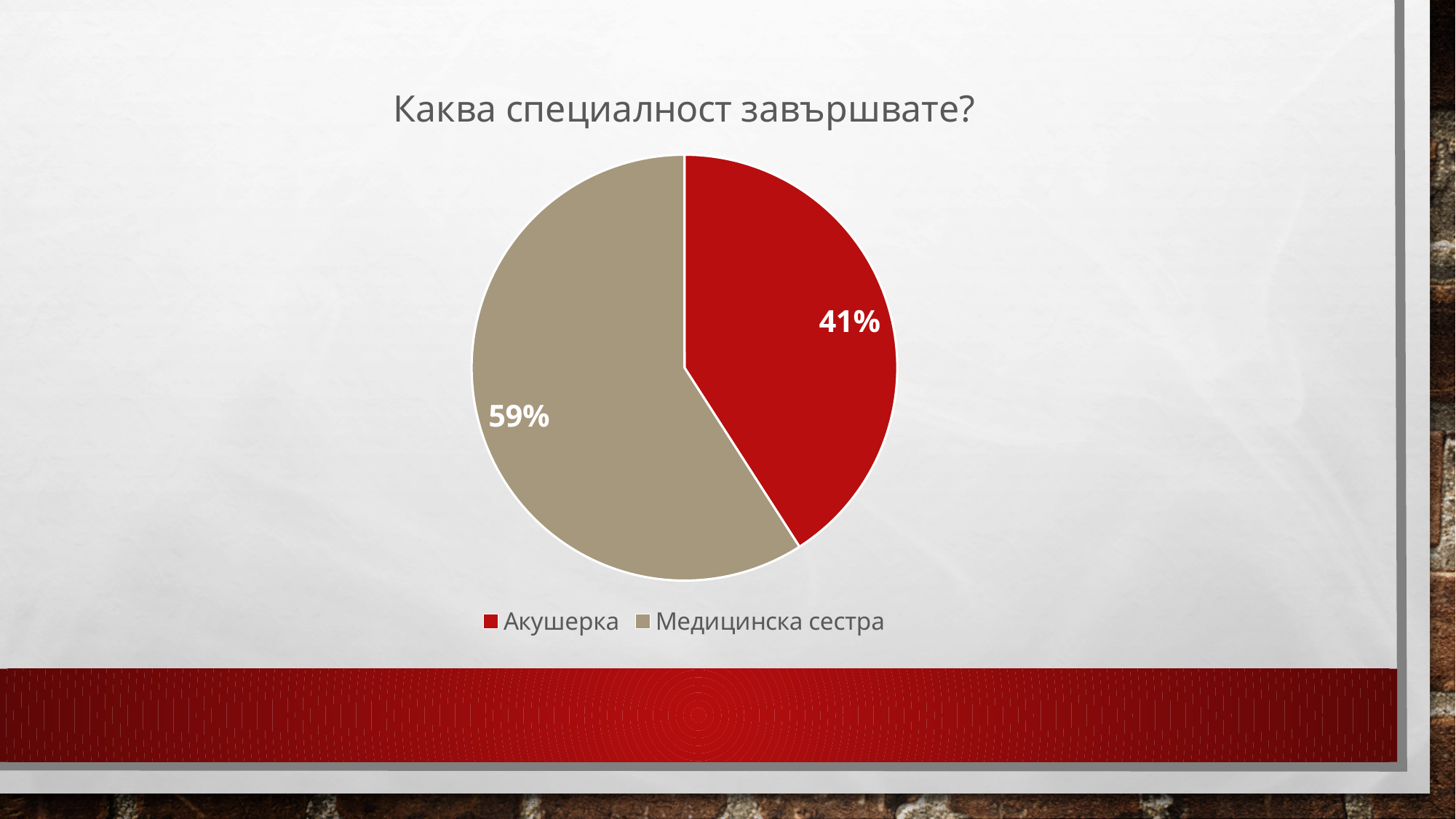
Which category has the smallest slice? Акушерка What is the chart's title? Каква специалност завършвате? What kind of chart is shown on the slide? pie chart Which is larger, the slice for Акушерка or the slice for Медицинска сестра? Медицинска сестра How many slices does the pie chart have? 2 Is the share for Акушерка greater or less than 50%? less What share of the pie does Акушерка have? 41% What share of the pie does Медицинска сестра have? 59% Which category has the largest slice? Медицинска сестра How many entries does the legend list? 2 What is the difference between the shares of Медицинска сестра and Акушерка? 18% What colour is the slice for Акушерка? red